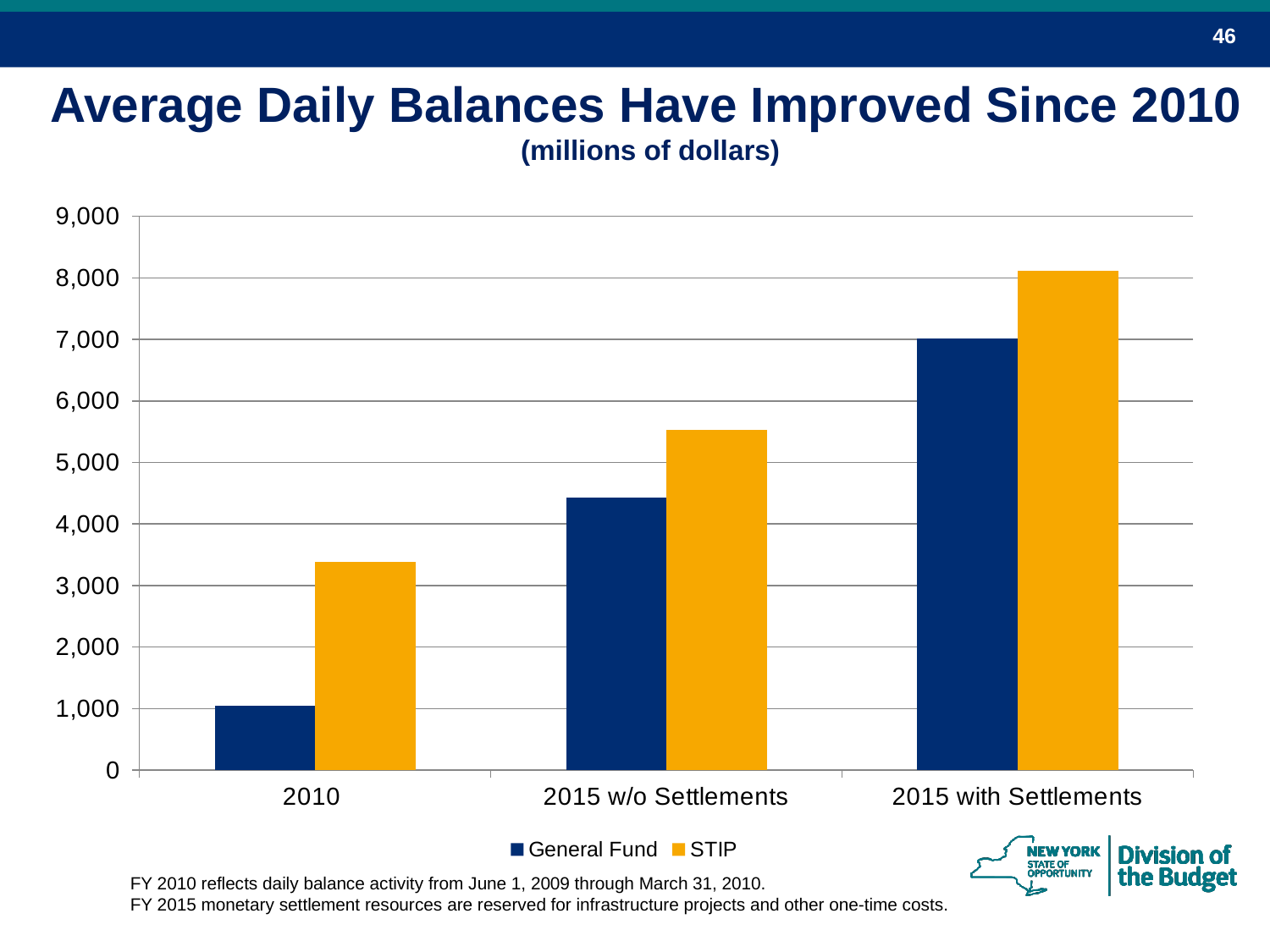
Is the STIP value for 2010 greater or less than 3,000? greater Do the General Fund values rise or fall moving from 2010 to 2015 with Settlements along the x axis? rise Is the General Fund value for 2015 w/o Settlements greater or less than 4,000? greater Which colour represents the STIP series in the chart? orange/yellow What kind of chart is shown on the slide? bar chart Which series and category has the highest bar in the chart? STIP, 2015 with Settlements Is the STIP value for 2015 with Settlements greater or less than 7,000? greater How many categories are shown on the x axis of the chart? 3 In 2010, which is larger, the General Fund bar or the STIP bar? STIP Which series and category has the lowest bar in the chart? General Fund, 2010 How many series does the chart's legend list? 2